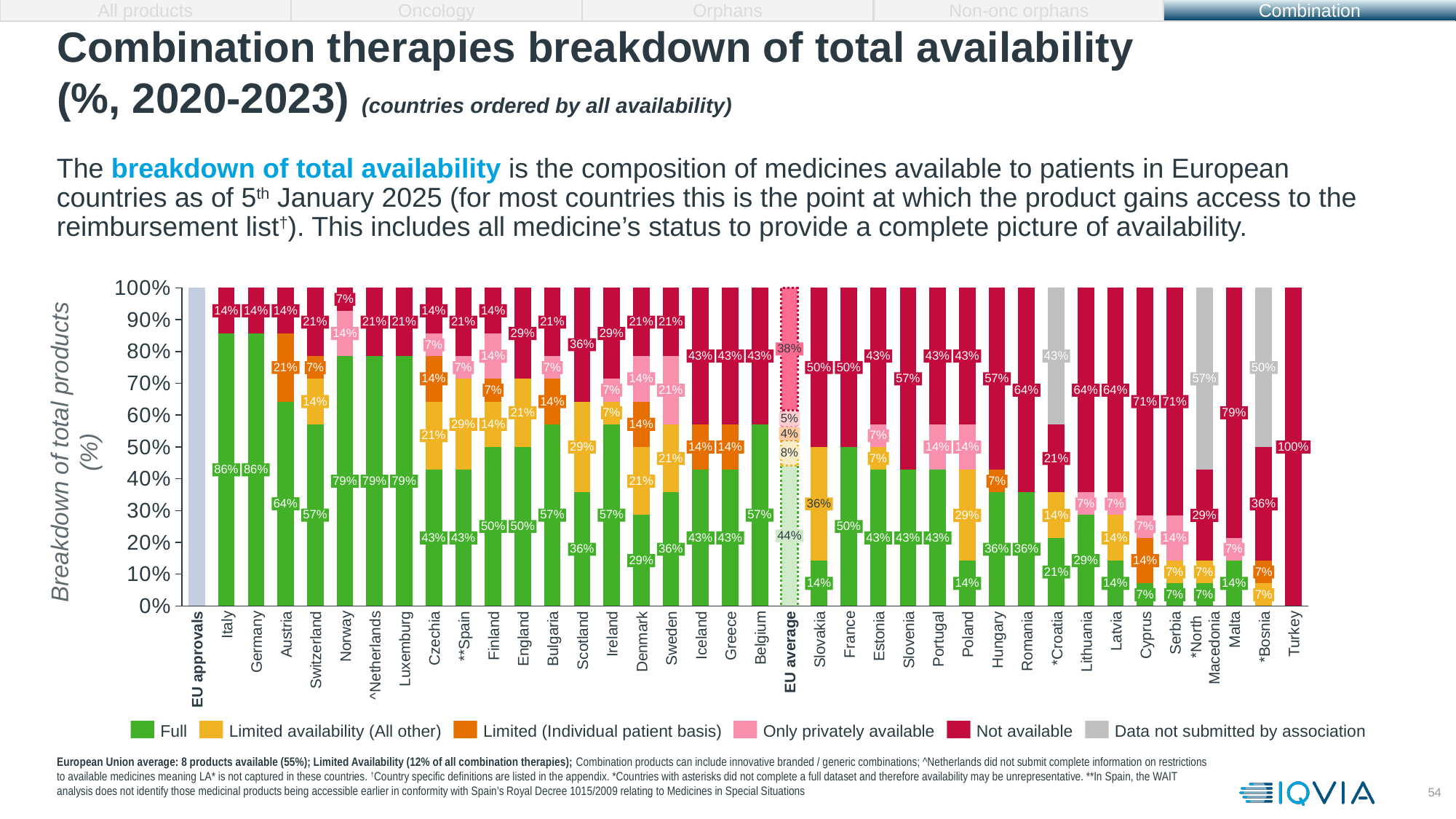
Which country has the highest 'Not available' share? Turkey What is the 'Not available' value for Turkey? 100% Which has a larger 'Full' availability value, Austria or Belgium? Austria What is the 'Limited availability (All other)' value for Slovakia? 36% What is the 'Data not submitted by association' value for *North Macedonia? 57% What type of chart is shown on the slide? Stacked bar chart What is the difference between the 'Full' availability values for Norway and Scotland? 43% What is the 'Only privately available' value for Sweden? 21% What is the 'Full' availability value for Italy? 86% What is the 'Full' availability value for the EU average bar? 44% How many series does the legend list? 6 Which legend entry is shown in grey? Data not submitted by association